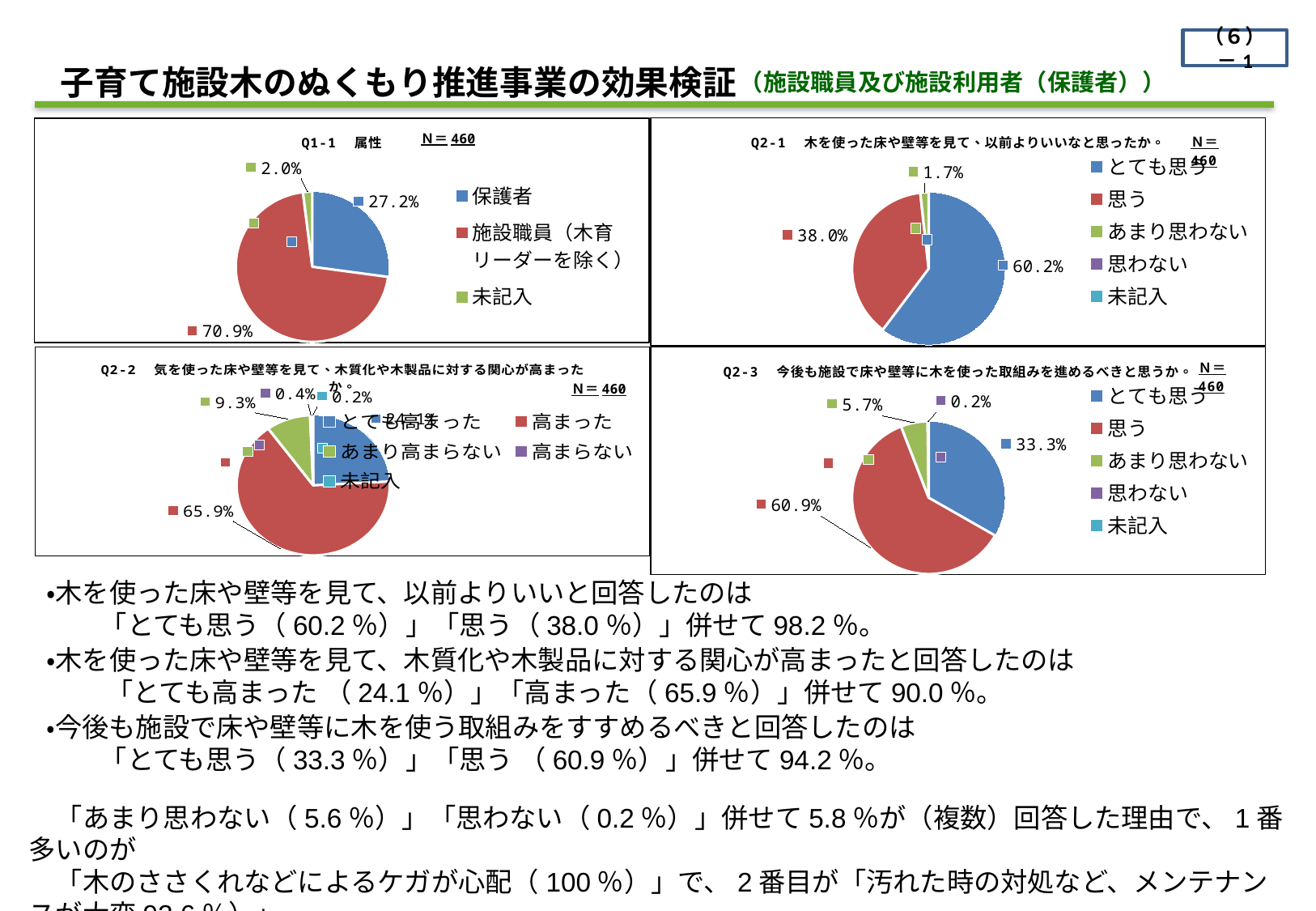
In the Q2-1 pie chart (木を使った床や壁等を見て、以前よりいいなと思ったか), what percentage answered とても思う? 60.2% In the Q2-3 pie chart, which is larger: the share for とても思う or the share for 思う? 思う In the Q2-2 pie chart, which category has the largest share? 高まった In the Q2-3 pie chart (今後も施設で床や壁等に木を使った取組みを進めるべきと思うか), what percentage answered 思う? 60.9% In the Q1-1 属性 pie chart, which category has the smallest share? 未記入 In the Q2-2 pie chart (関心が高まったか), what percentage answered 高まった? 65.9% In the Q1-1 属性 pie chart, what percentage is 施設職員（木育リーダーを除く）? 70.9% How many entries does the legend of the Q2-1 pie chart list? 5 In the Q1-1 属性 pie chart, what percentage is 保護者? 27.2% In the Q2-1 pie chart, what is the difference between the とても思う share and the 思う share? 22.2% What type of chart is used for Q2-3? Pie chart In the Q2-2 pie chart, what percentage answered あまり高まらない? 9.3%